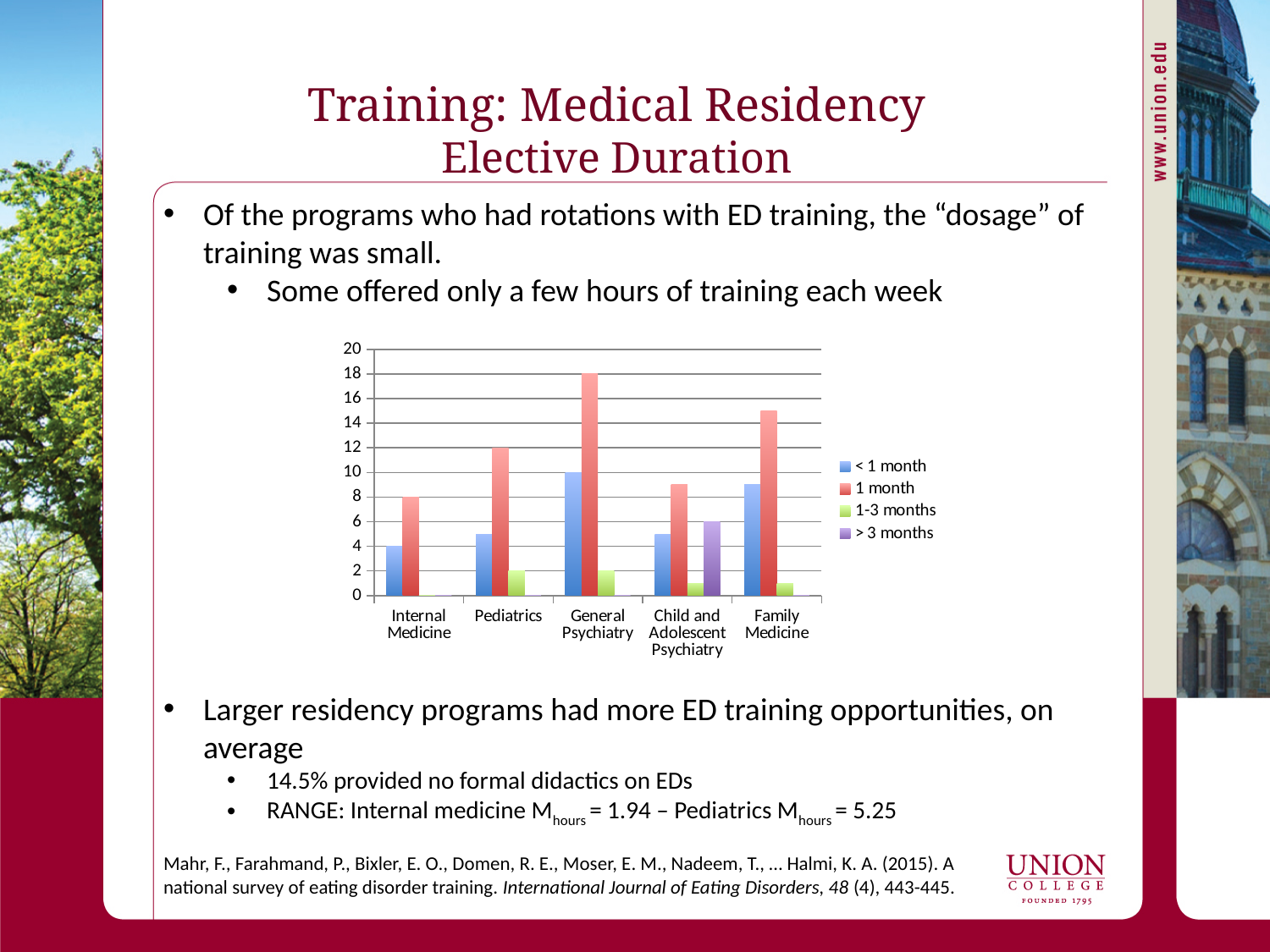
What is the value for the 1 month series for General Psychiatry? 18 What is the value for the 1 month series for Pediatrics? 12 What is the value for the < 1 month series for Internal Medicine? 4 Which category has the highest value for the 1 month series? General Psychiatry What kind of chart is shown on the slide? bar chart What is the difference between the 1 month and < 1 month values for General Psychiatry? 8 What is the value for the > 3 months series for Child and Adolescent Psychiatry? 6 How many categories are shown on the x axis? 5 Which category has the lowest value for the < 1 month series? Internal Medicine Which category is the only one with a bar for the > 3 months series? Child and Adolescent Psychiatry How many series does the legend list? 4 Is the value for the 1 month series for Family Medicine greater or less than 14? greater